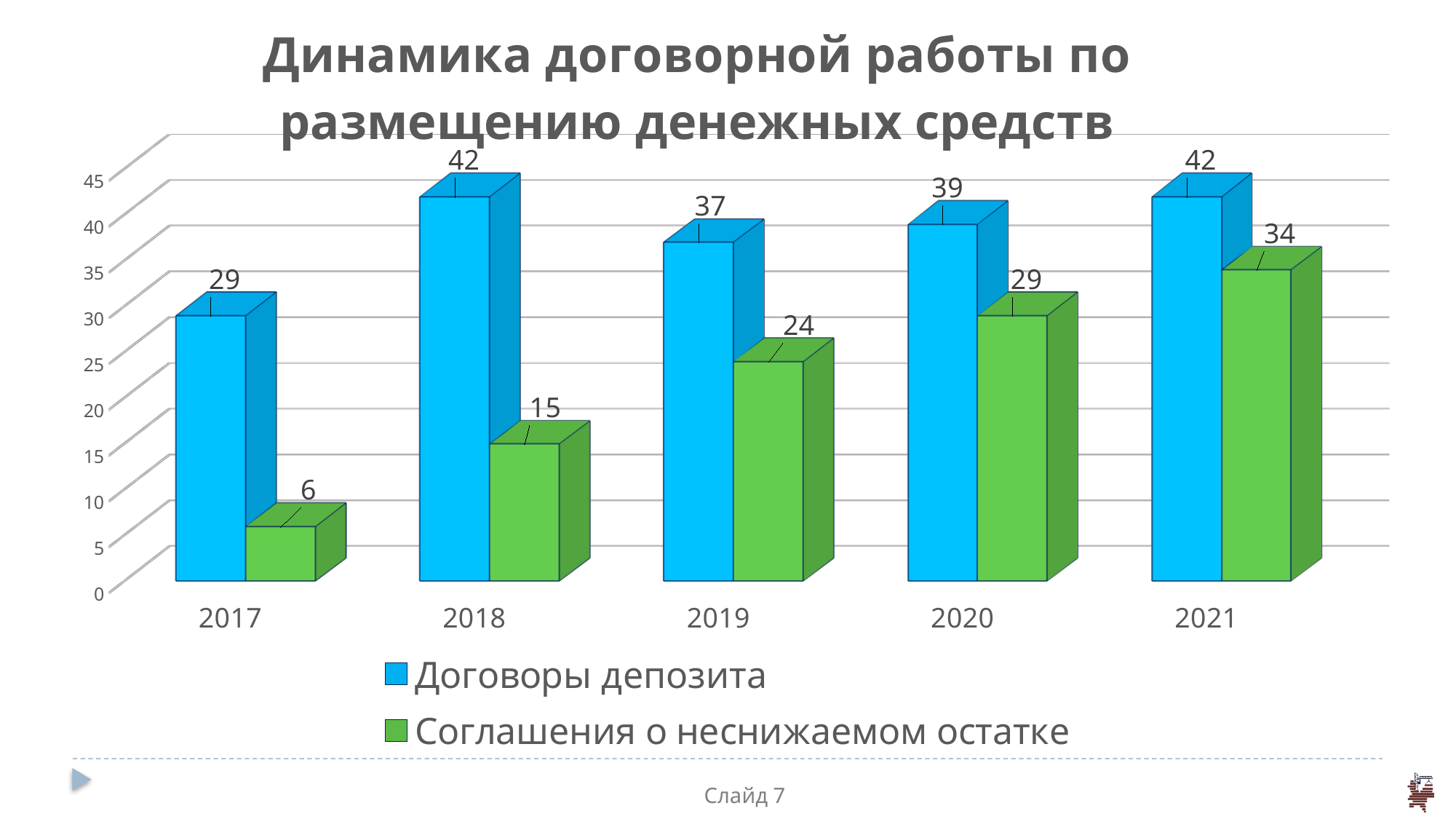
What is the difference between Договоры депозита and Соглашения о неснижаемом остатке in 2019? 13 How many years are shown on the x axis? 5 What is the value for Соглашения о неснижаемом остатке in 2021? 34 What kind of chart is shown? bar chart What is the value for Договоры депозита in 2018? 42 Does Соглашения о неснижаемом остатке rise or fall from 2017 to 2021? rise In which year is Соглашения о неснижаемом остатке highest? 2021 How many series does the legend list? 2 What colour are the bars for Договоры депозита? blue In which year is Договоры депозита lowest? 2017 Which is larger in 2020: Договоры депозита or Соглашения о неснижаемом остатке? Договоры депозита What is the value for Соглашения о неснижаемом остатке in 2017? 6